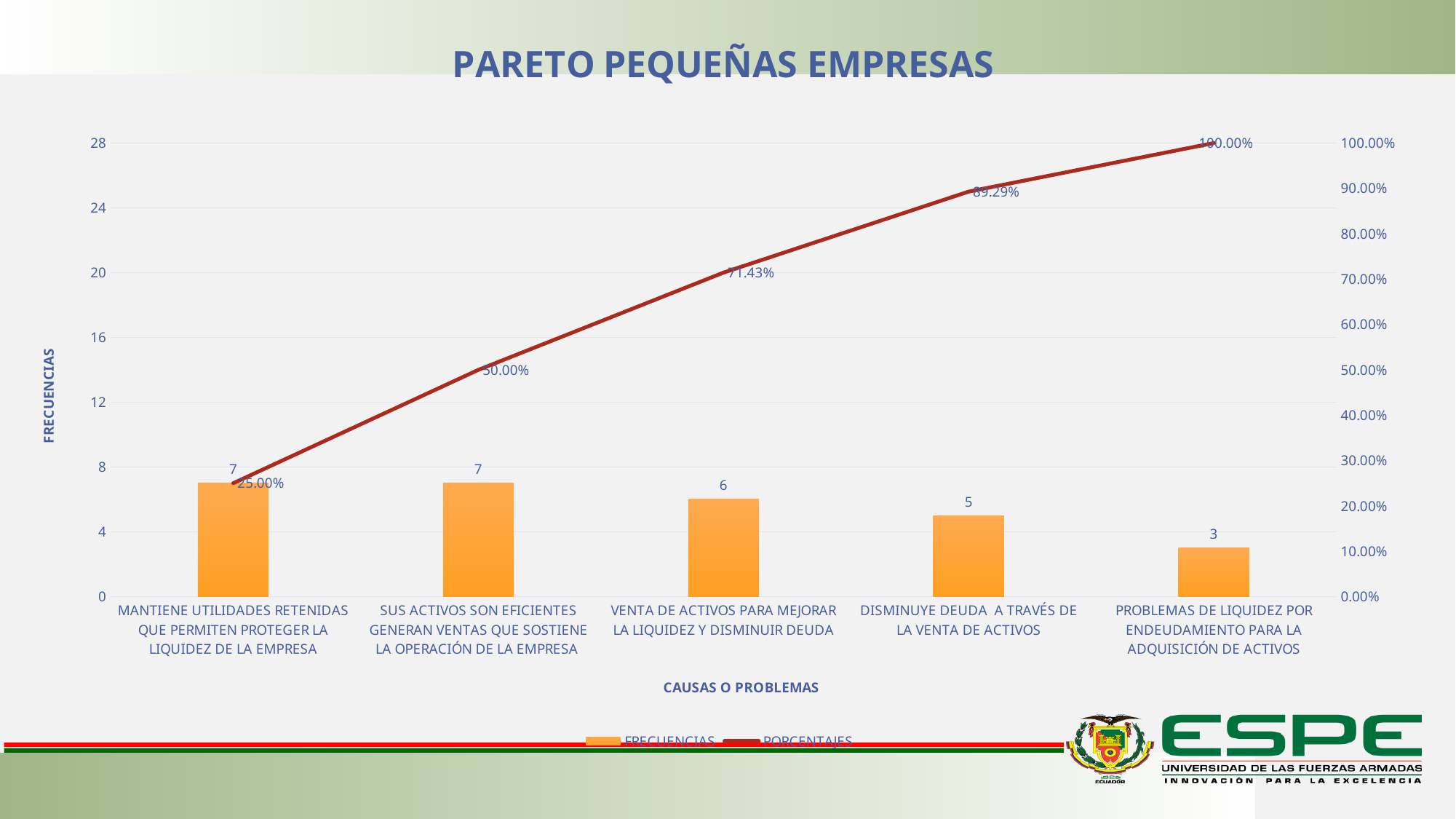
Which category has the lowest frequency? PROBLEMAS DE LIQUIDEZ POR ENDEUDAMIENTO PARA LA ADQUISICIÓN DE ACTIVOS Does the cumulative percentage line rise or fall from left to right? rise How many categories are shown on the x axis? 5 What is the frequency for "PROBLEMAS DE LIQUIDEZ POR ENDEUDAMIENTO PARA LA ADQUISICIÓN DE ACTIVOS"? 3 What cumulative percentage is shown at "DISMINUYE DEUDA A TRAVÉS DE LA VENTA DE ACTIVOS"? 89.29% What is the difference in frequency between "VENTA DE ACTIVOS PARA MEJORAR LA LIQUIDEZ Y DISMINUIR DEUDA" and "PROBLEMAS DE LIQUIDEZ POR ENDEUDAMIENTO PARA LA ADQUISICIÓN DE ACTIVOS"? 3 Which has a higher frequency: "SUS ACTIVOS SON EFICIENTES GENERAN VENTAS QUE SOSTIENE LA OPERACIÓN DE LA EMPRESA" or "DISMINUYE DEUDA A TRAVÉS DE LA VENTA DE ACTIVOS"? SUS ACTIVOS SON EFICIENTES GENERAN VENTAS QUE SOSTIENE LA OPERACIÓN DE LA EMPRESA What is the label of the left vertical axis? FRECUENCIAS What cumulative percentage is shown at "VENTA DE ACTIVOS PARA MEJORAR LA LIQUIDEZ Y DISMINUIR DEUDA"? 71.43% How many series does the legend list? 2 What is the frequency for "VENTA DE ACTIVOS PARA MEJORAR LA LIQUIDEZ Y DISMINUIR DEUDA"? 6 What is the title of the chart? PARETO PEQUEÑAS EMPRESAS